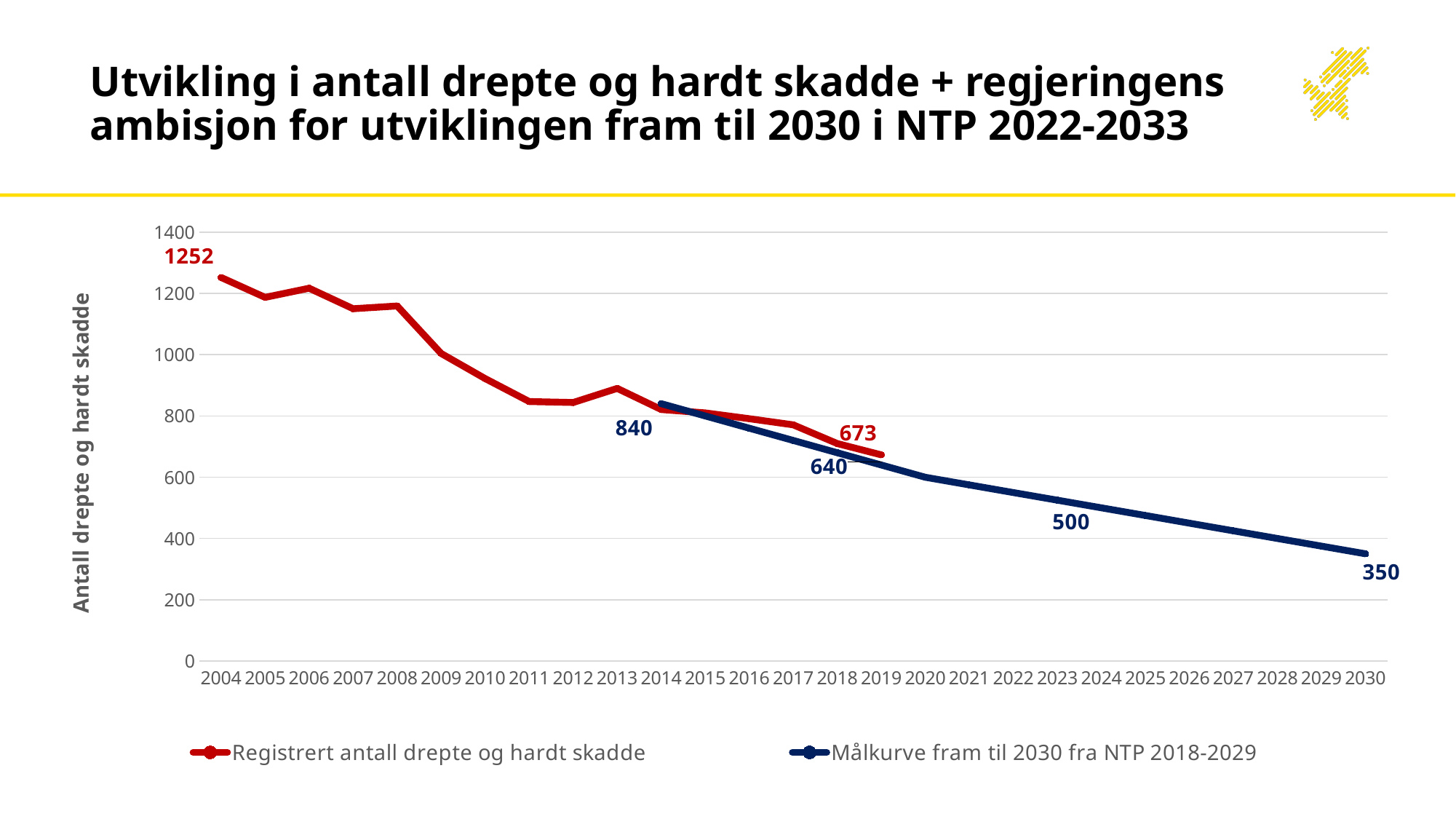
In which year is 'Registrert antall drepte og hardt skadde' highest? 2004 Do the values of 'Registrert antall drepte og hardt skadde' generally rise or fall from 2004 to 2019? fall How many series does the legend list? 2 What is the value of 'Registrert antall drepte og hardt skadde' in 2004? 1252 What kind of chart is shown on the slide? line chart What is the title of the vertical axis? Antall drepte og hardt skadde What is the value of 'Registrert antall drepte og hardt skadde' in 2019? 673 What is the difference between the registered value in 2004 and the registered value in 2019? 579 What is the value of 'Målkurve fram til 2030 fra NTP 2018-2029' in 2030? 350 By how much does the target curve fall from 2014 to 2030? 490 Is the registered value for 2011 greater or less than 1000? less What is the value of 'Målkurve fram til 2030 fra NTP 2018-2029' in 2014? 840